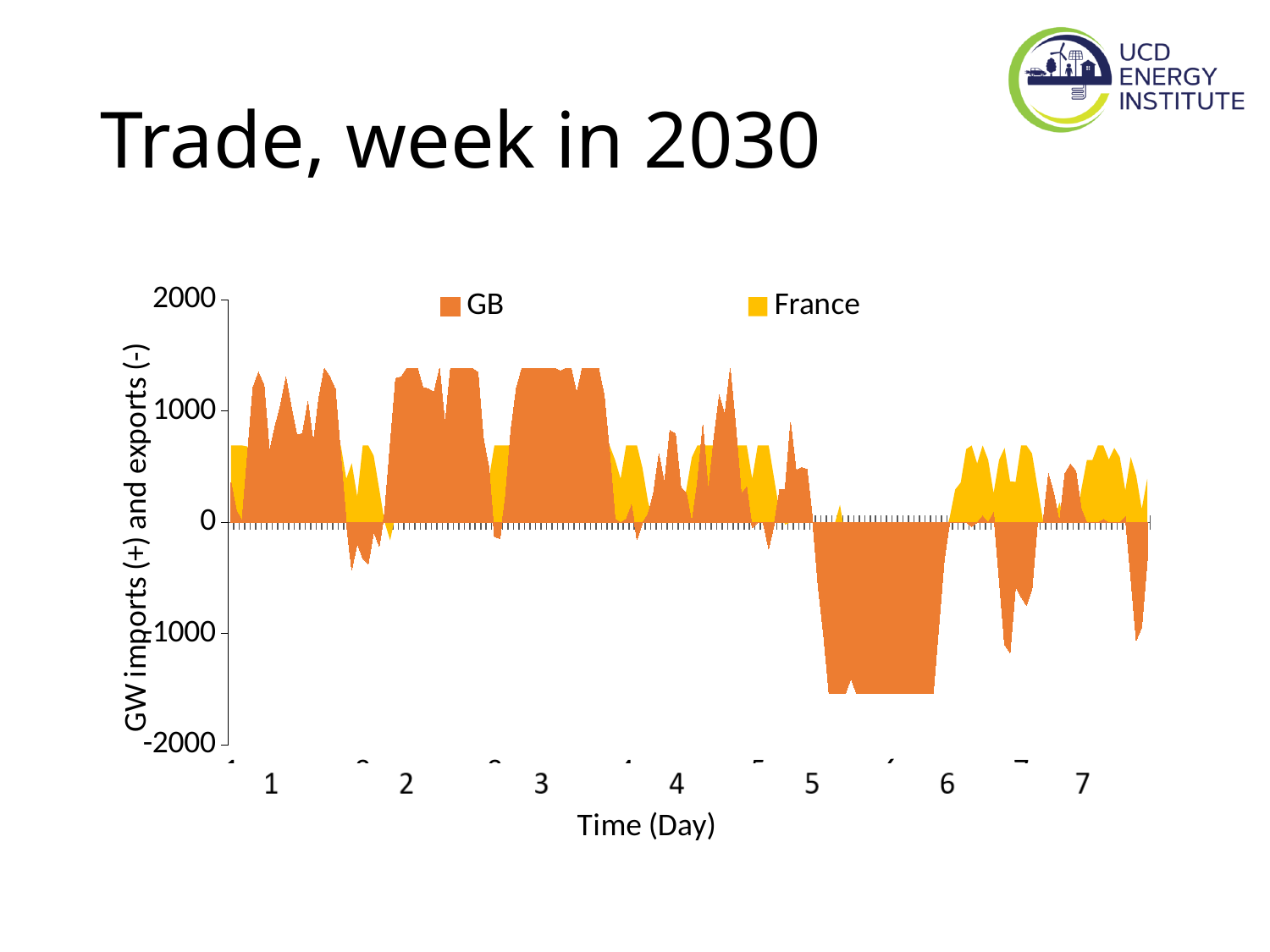
How many series does the chart legend list? 2 Which series reaches the higher peak value over the week, GB or France? GB Is the value for GB around day 5.5 greater or less than -1000? less What is the label of the x axis? Time (Day) Which series drops to the lowest (most negative) value during the week? GB Is the peak value for GB during day 2 greater or less than 1000? greater How many days are labelled along the x axis? 7 What is the label of the y axis? GW imports (+) and exports (-) What kind of chart is shown on the slide? Area chart Is the highest value reached by France greater or less than 1000? less What is the title of the chart on the slide? Trade, week in 2030